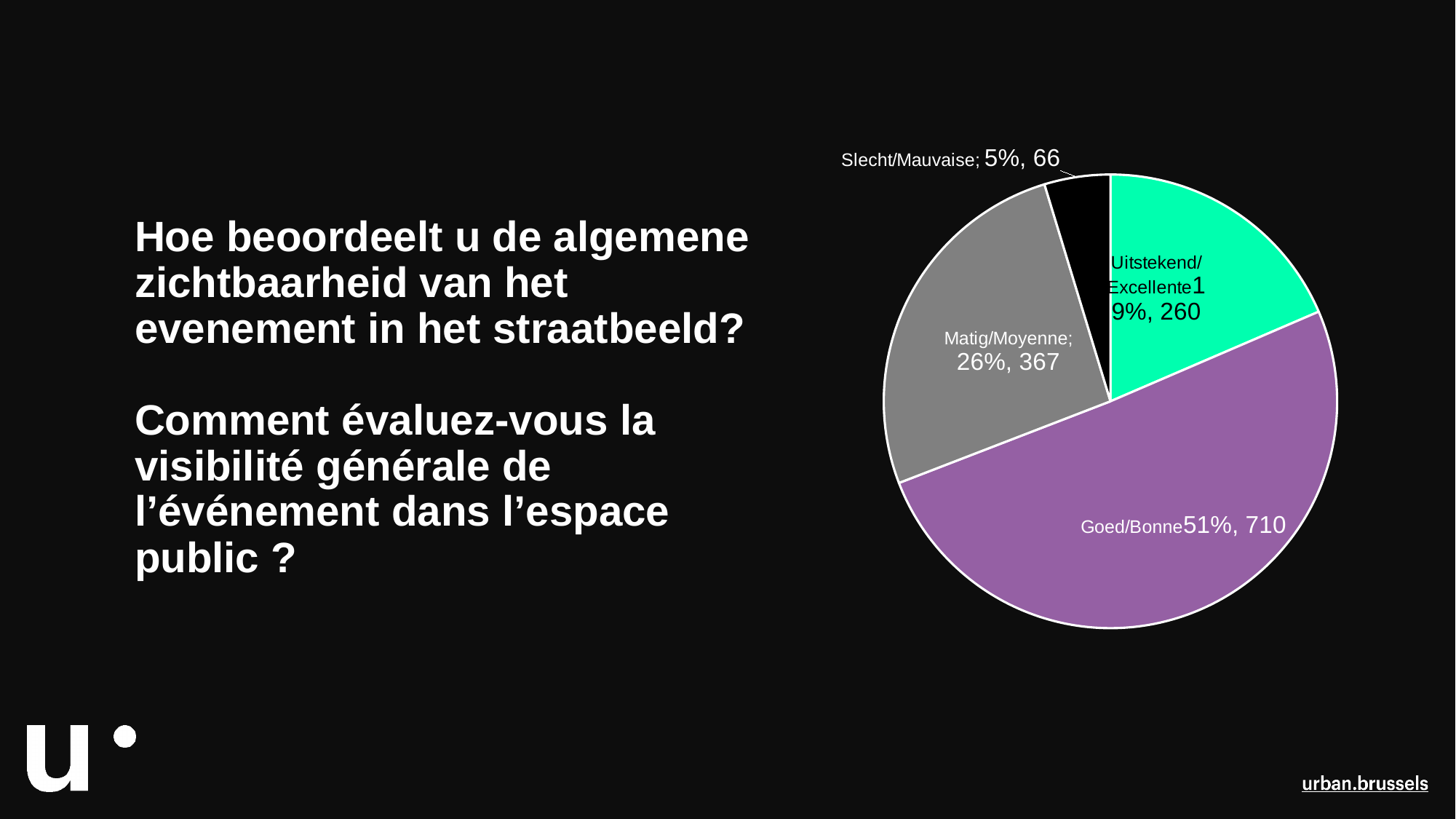
What is the count shown for Matig/Moyenne? 367 Which category has the smallest slice? Slecht/Mauvaise What is the count shown for Uitstekend/Excellente? 260 Which category has the largest slice? Goed/Bonne How many slices does the pie chart have? 4 What is the difference in count between Uitstekend/Excellente and Slecht/Mauvaise? 194 Which has a larger count, Uitstekend/Excellente or Matig/Moyenne? Matig/Moyenne What is the difference in count between Goed/Bonne and Matig/Moyenne? 343 What percentage share does the Goed/Bonne slice have? 51% What colour is the Goed/Bonne slice? purple What percentage share does the Slecht/Mauvaise slice have? 5% What kind of chart is shown on the slide? pie chart